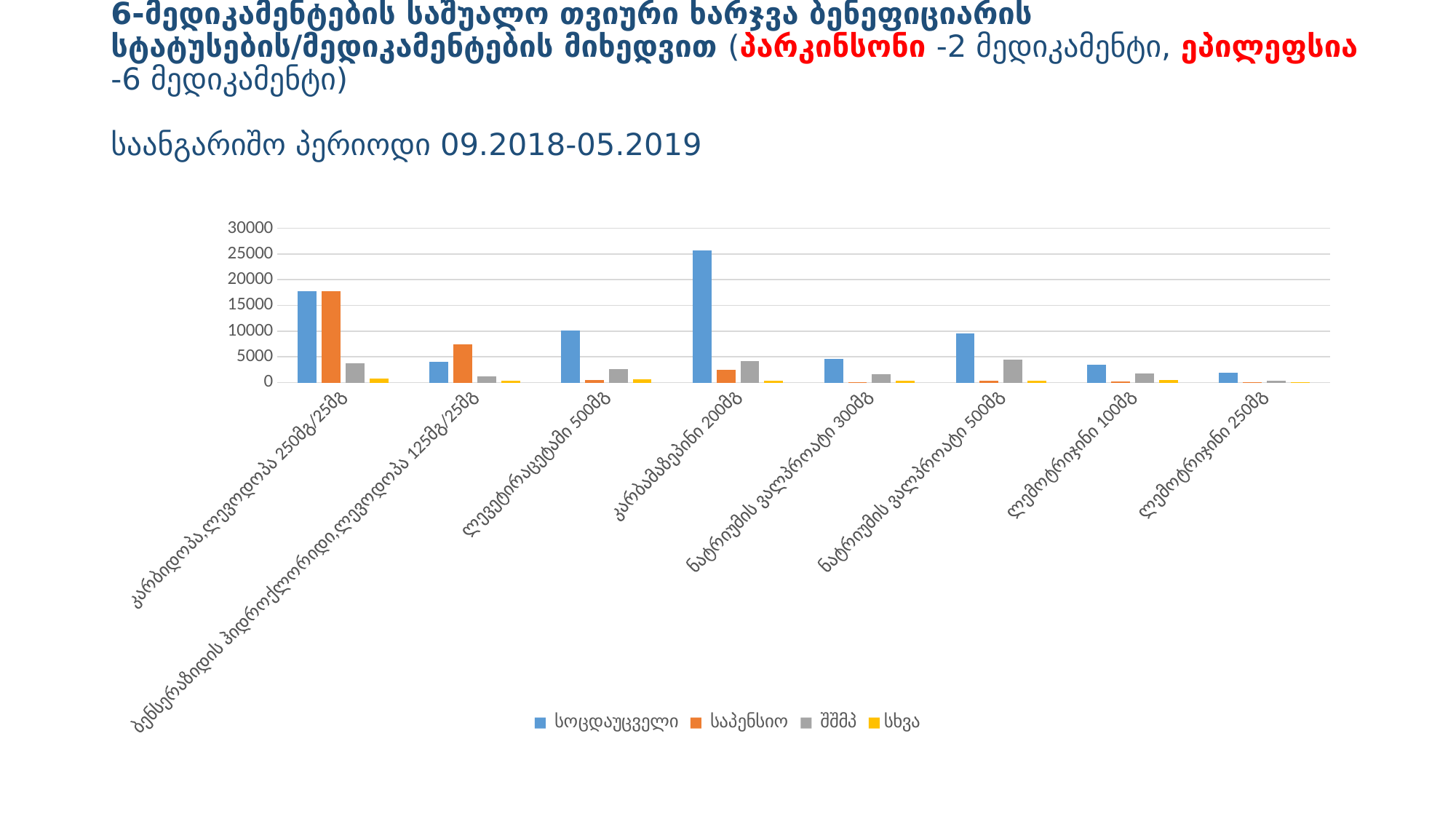
Which category has the highest სოციალური (blue) bar? კარბამაზეპინი 200მგ What kind of chart is shown on the slide? bar chart Which category has the highest საპენსიო (orange) bar? კარბიდოპა,ლევოდოპა 250მგ/25მგ How many series does the chart legend list? 4 How many medication categories are shown on the x axis of the chart? 8 Which colour represents the სხვა series in the chart legend? yellow Is the საპენსიო value for ბენსერაზიდის ჰიდროქლორიდი,ლევოდოპა 125მგ/25მგ greater or less than 5000? greater